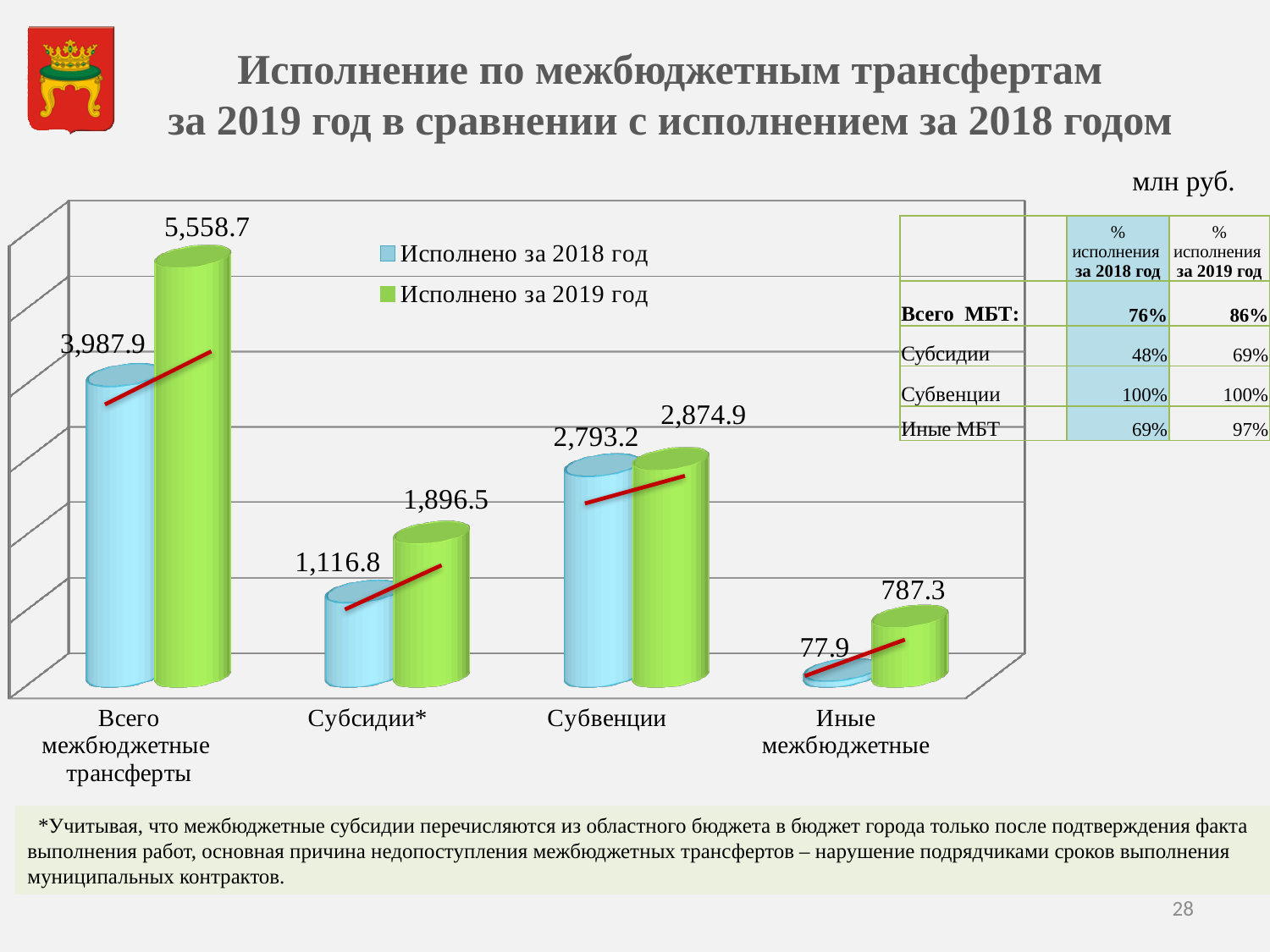
Which is larger for Субсидии*: the value for Исполнено за 2018 год or for Исполнено за 2019 год? Исполнено за 2019 год What is the difference between the 2019 and 2018 values for Всего межбюджетные трансферты? 1,570.8 Which category has the highest value in the series Исполнено за 2019 год? Всего межбюджетные трансферты What is the value for Субсидии* in the series Исполнено за 2018 год? 1,116.8 What is the difference between the 2019 and 2018 values for Иные межбюджетные? 709.4 How many series does the chart legend list? 2 What is the value for Иные межбюджетные in the series Исполнено за 2019 год? 787.3 What is the value for Субвенции in the series Исполнено за 2019 год? 2,874.9 Which category has the lowest value in the series Исполнено за 2018 год? Иные межбюджетные What kind of chart is shown on the slide? Bar chart How many categories are shown on the x axis of the chart? 4 What is the value for Всего межбюджетные трансферты in the series Исполнено за 2018 год? 3,987.9